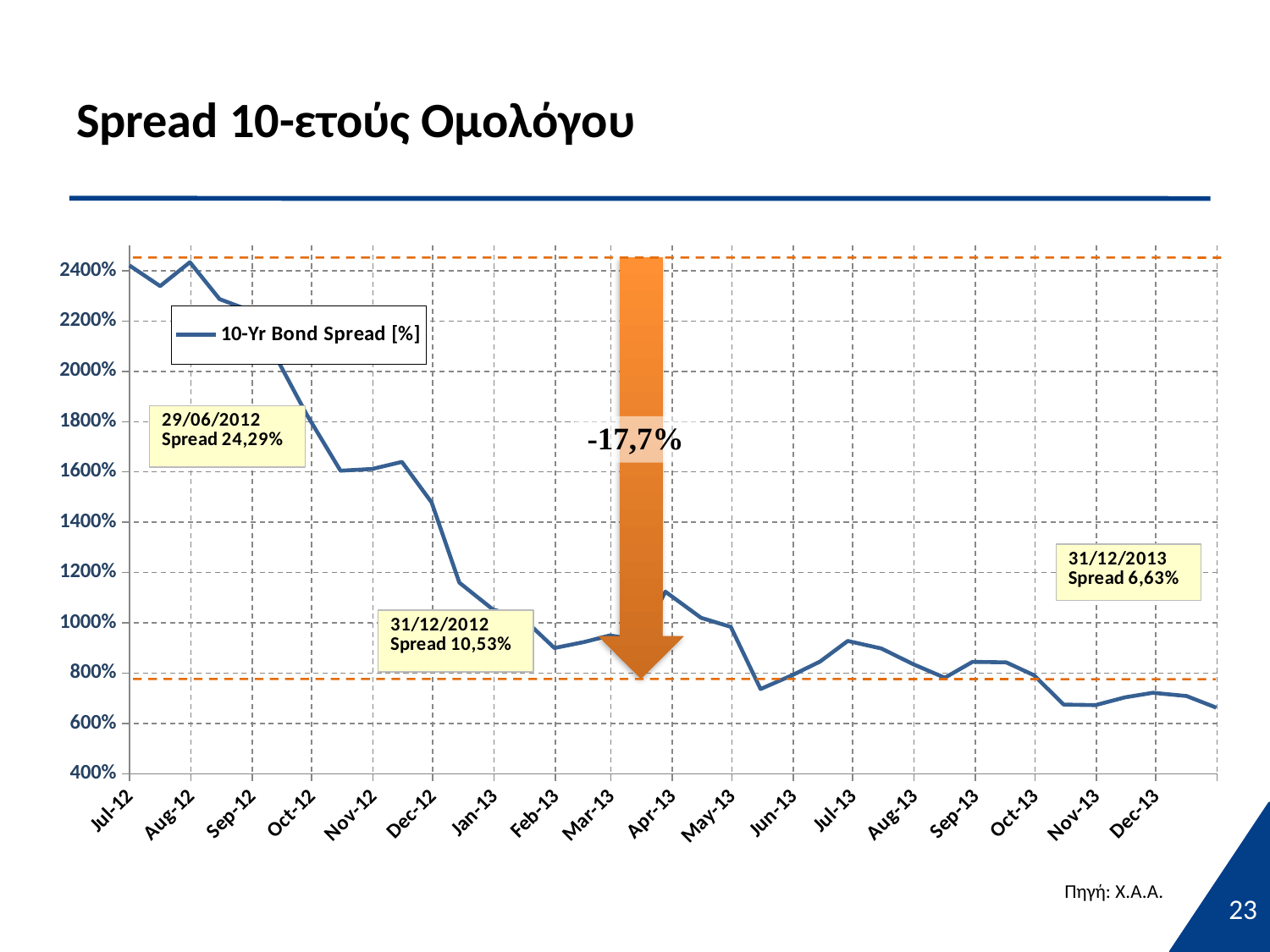
What spread value is annotated for 29/06/2012? 24,29% Is the value for Nov-12 greater or less than 1800%? less Does the 10-Yr Bond Spread generally rise or fall from Jul-12 to Dec-13? Fall What spread value is annotated for 31/12/2013? 6,63% What change is printed on the large orange arrow in the chart? -17,7% Is the value for Jul-12 greater or less than 2200%? greater How many month labels are shown on the x axis? 18 What spread value is annotated for 31/12/2012? 10,53% What kind of chart is shown on the slide? Line chart Which is larger, the spread at Jul-12 or at Dec-13? Jul-12 What is the name of the series shown in the legend? 10-Yr Bond Spread [%] How many series does the legend list? 1